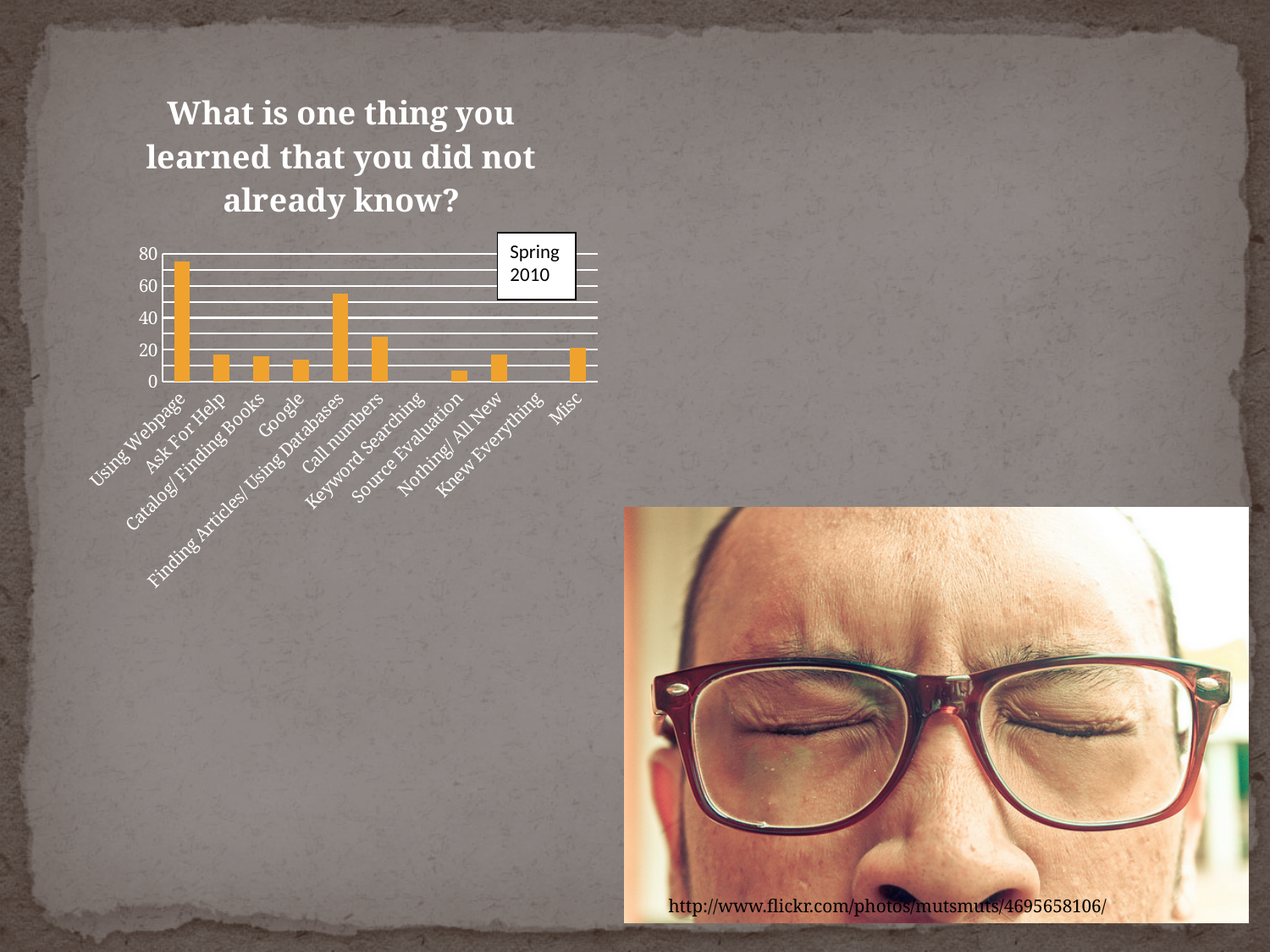
Is the value for Ask For Help greater or less than 40? less Is the value for Using Webpage greater or less than 60? greater Which is larger, the value for Finding Articles/Using Databases or the value for Call numbers? Finding Articles/Using Databases What kind of chart is shown on the slide? bar chart How many categories are shown on the x axis of the chart? 11 What is the title of the chart? What is one thing you learned that you did not already know? Which category has the highest value? Using Webpage Is the value for Finding Articles/Using Databases greater or less than 40? greater Which is larger, the value for Using Webpage or the value for Finding Articles/Using Databases? Using Webpage